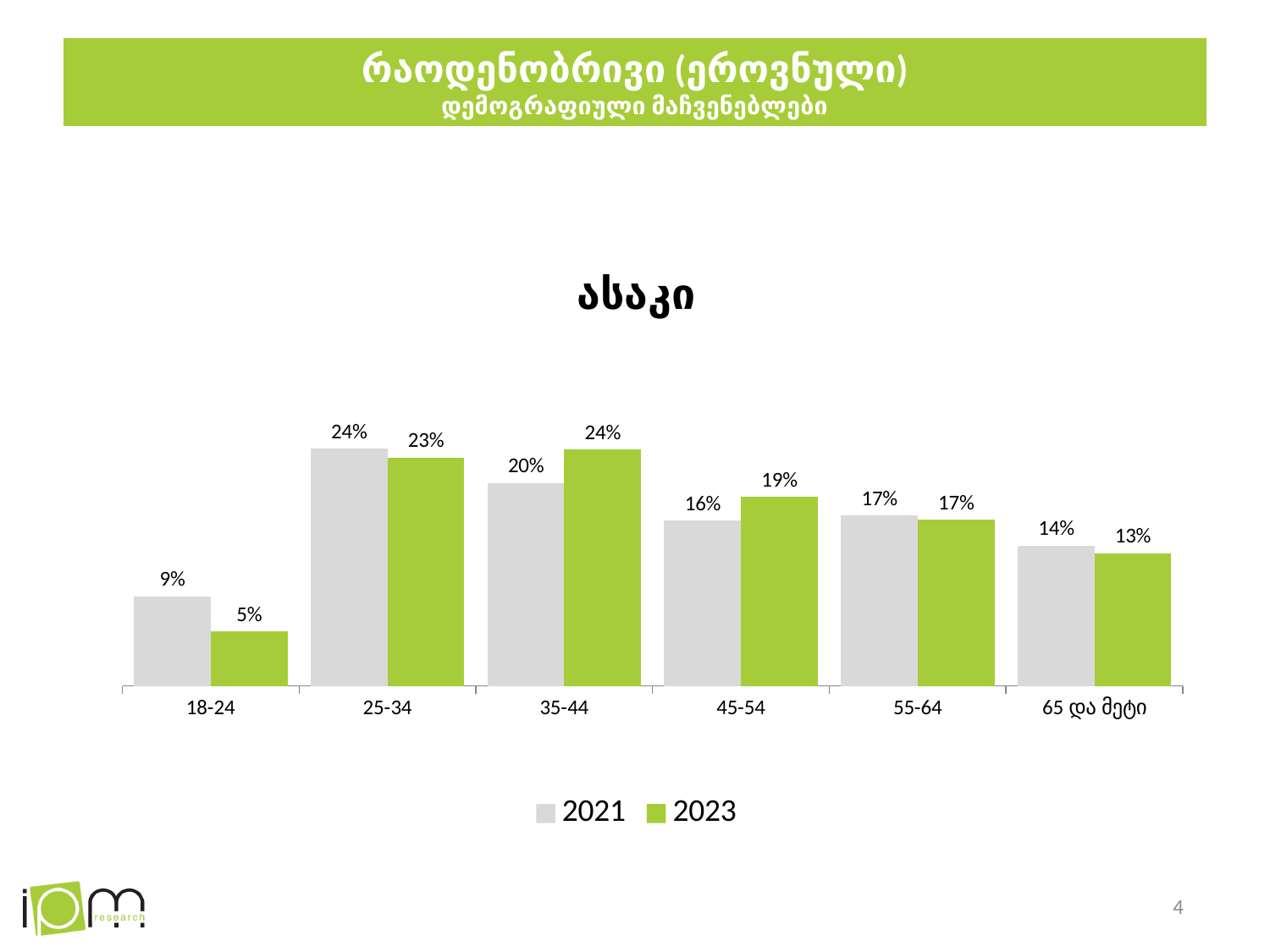
Which age group has the highest value in the 2021 series? 25-34 What is the value for the 35-44 age group in 2023? 24% What is the title of the chart? ასაკი Which is larger for the 45-54 age group: the 2021 value or the 2023 value? 2023 What is the difference between the 2023 and 2021 values for the 35-44 age group? 4% How many series does the legend list? 2 What is the value for the 65 და მეტი age group in 2023? 13% What is the difference between the 2021 and 2023 values for the 18-24 age group? 4% What kind of chart is shown on the slide? bar chart How many age groups are shown on the x axis? 6 Which age group has the lowest value in the 2023 series? 18-24 What is the value for the 18-24 age group in 2021? 9%